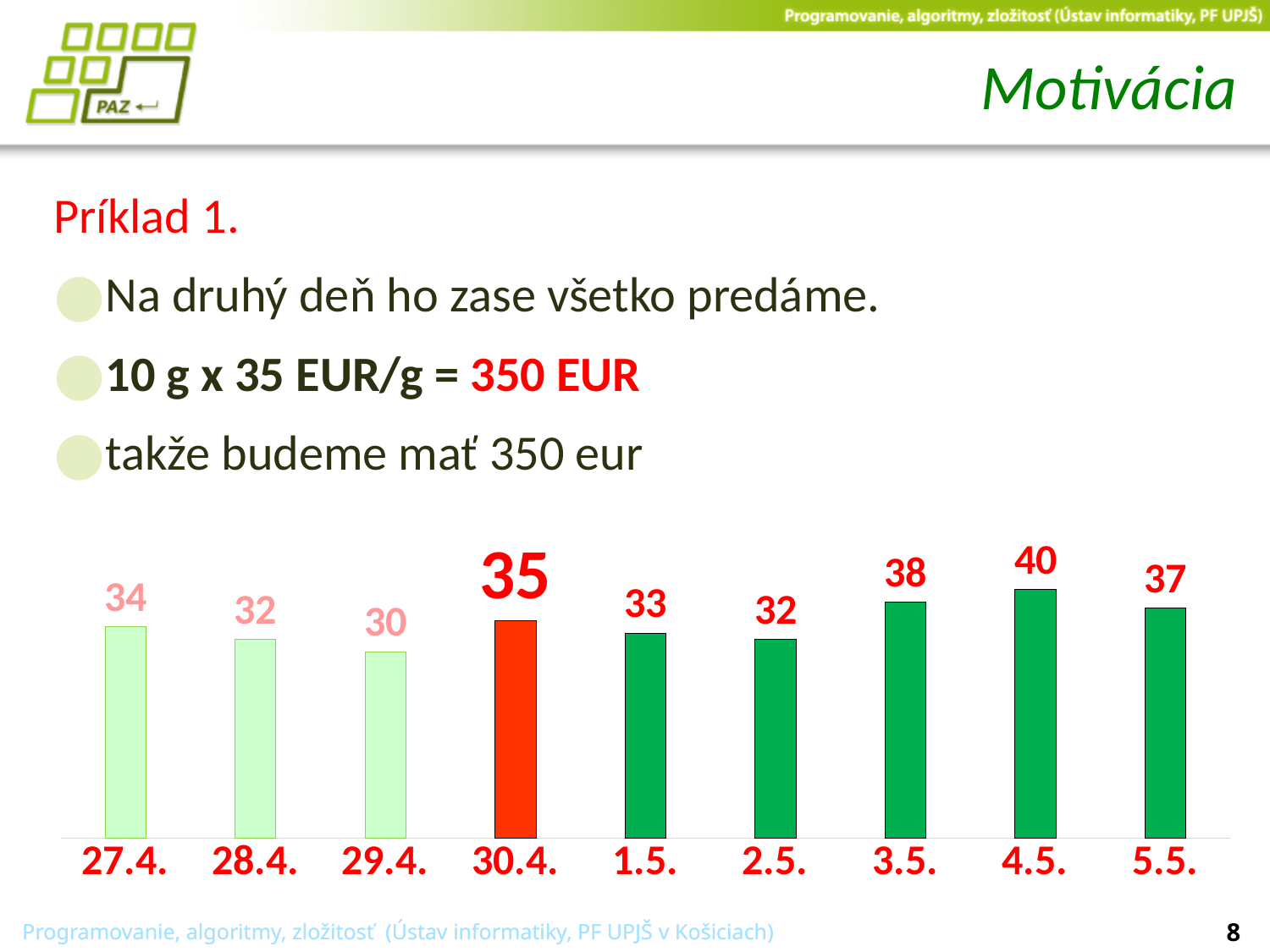
What is the value for 27.4.? 34 Which date has the lowest value? 29.4. What is the difference between the values for 4.5. and 29.4.? 10 Which bar is highlighted in red? 30.4. Which date has the highest value? 4.5. What is the value for 4.5.? 40 What is the difference between the values for 30.4. and 1.5.? 2 What is the value for 30.4.? 35 Which is larger, the value for 3.5. or the value for 5.5.? 3.5. How many dates are shown on the x axis? 9 What kind of chart is shown on the slide? bar chart Do the values rise or fall from 27.4. to 29.4.? fall